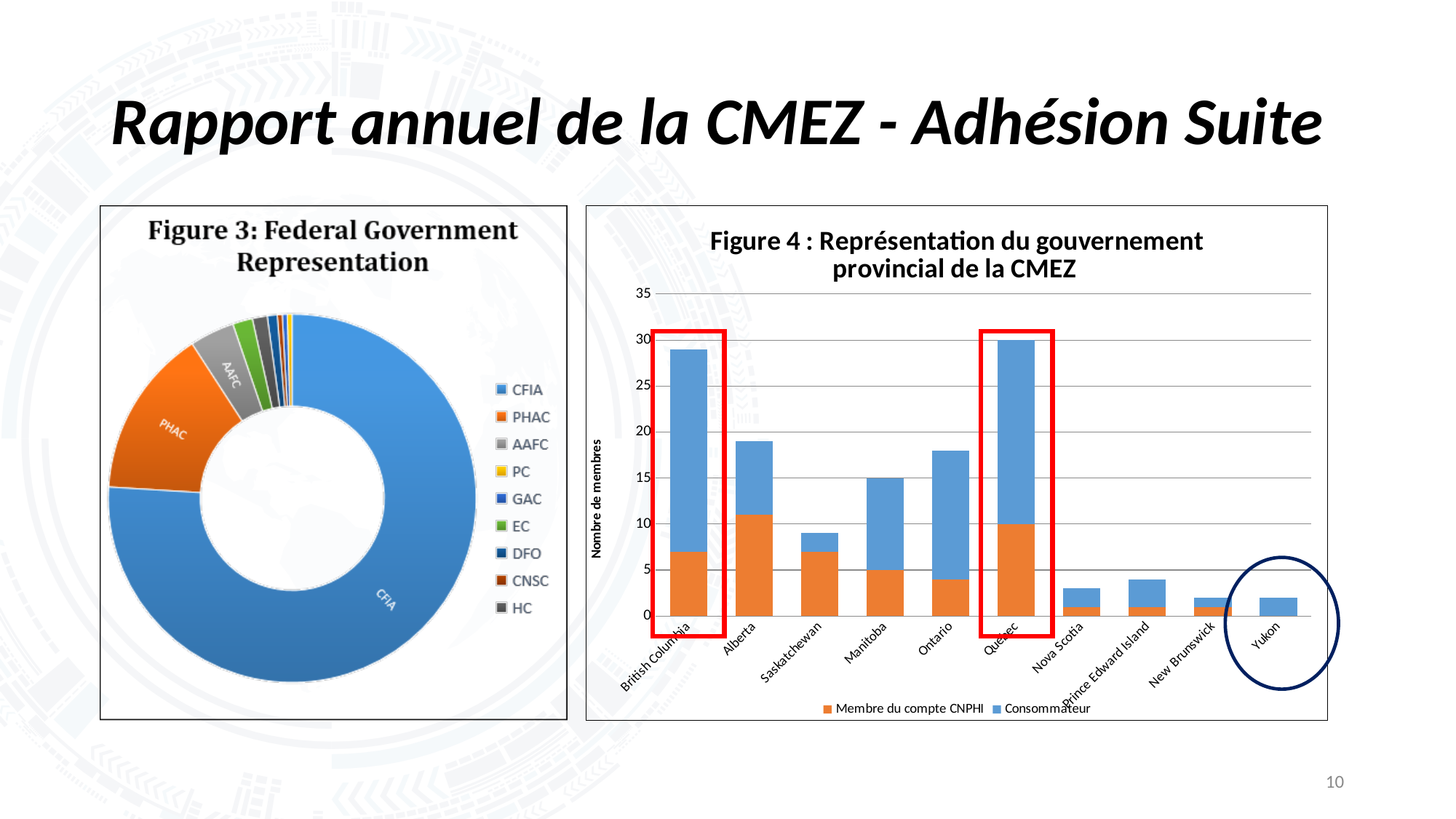
In Figure 4, is the total for Alberta greater or less than 20? less What kind of chart is Figure 4 : Représentation du gouvernement provincial de la CMEZ? bar chart In Figure 4, how many series does the legend list? 2 In Figure 3, which organisation has the largest share? CFIA What kind of chart is Figure 3: Federal Government Representation? doughnut (pie) chart In Figure 4, what is the total number of members for Manitoba? 15 In Figure 4, how many provinces and territories are shown on the x axis? 10 In Figure 4, is the total for Ontario greater or less than 15? greater In Figure 4, what is the Membre du compte CNPHI value for Quebec? 10 In Figure 4, which has a larger total, Ontario or Manitoba? Ontario In Figure 4, what is the total number of members for Quebec? 30 In Figure 3, how many entries does the legend list? 9